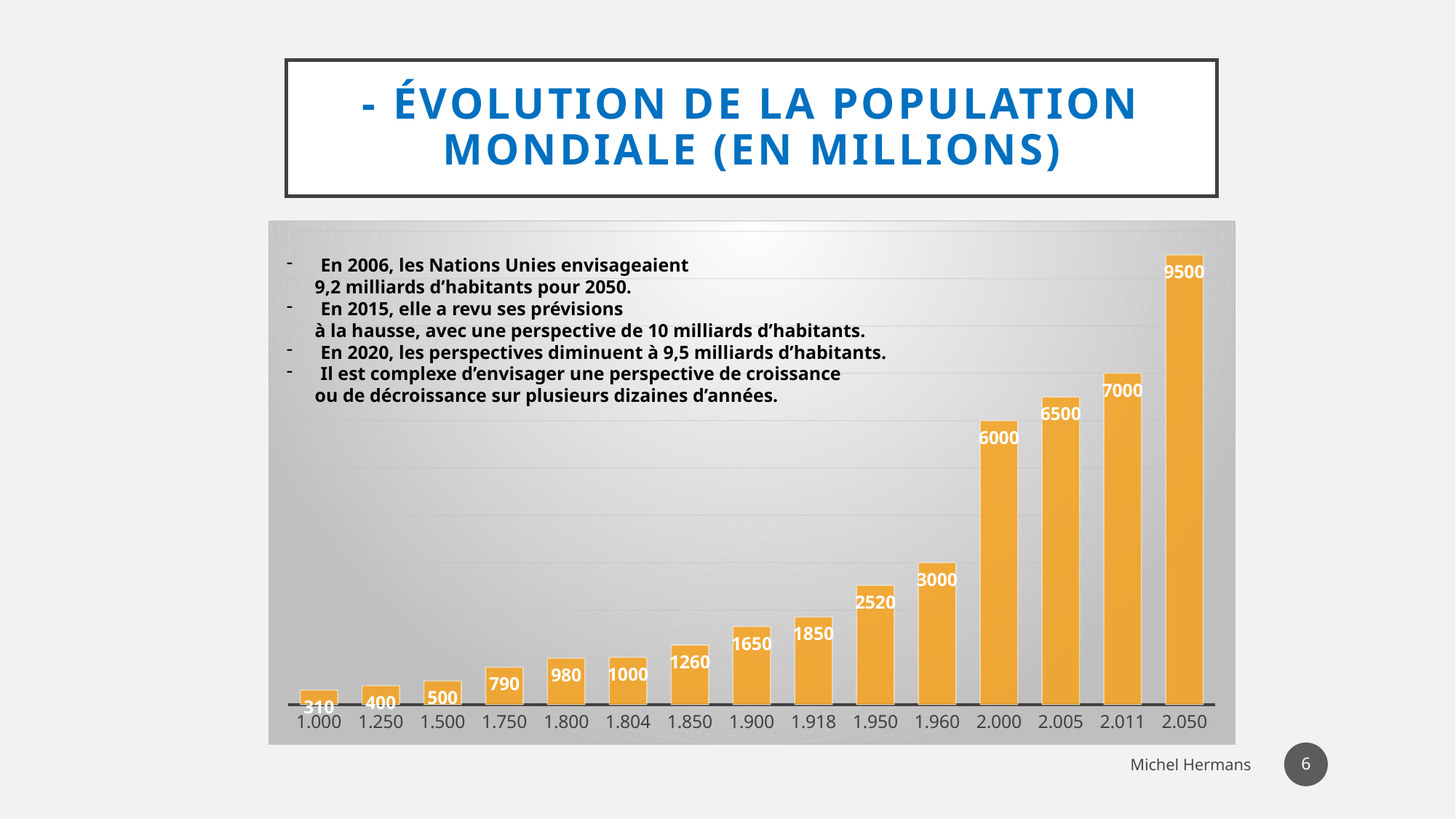
What is the difference between the values for 2.011 and 2.005? 500 What is the value for 1.750? 790 What is the difference between the values for 1.960 and 1.950? 480 Do the values rise or fall from left to right along the x axis? rise Which is larger, the value for 1.850 or the value for 1.918? 1.918 What is the title of the slide containing the chart? Évolution de la population mondiale (en millions) Which category has the highest value? 2.050 What kind of chart is shown on the slide? bar chart What is the value for 2.050? 9500 What is the value for 1.900? 1650 How many categories are shown on the x axis? 15 Which category has the lowest value? 1.000